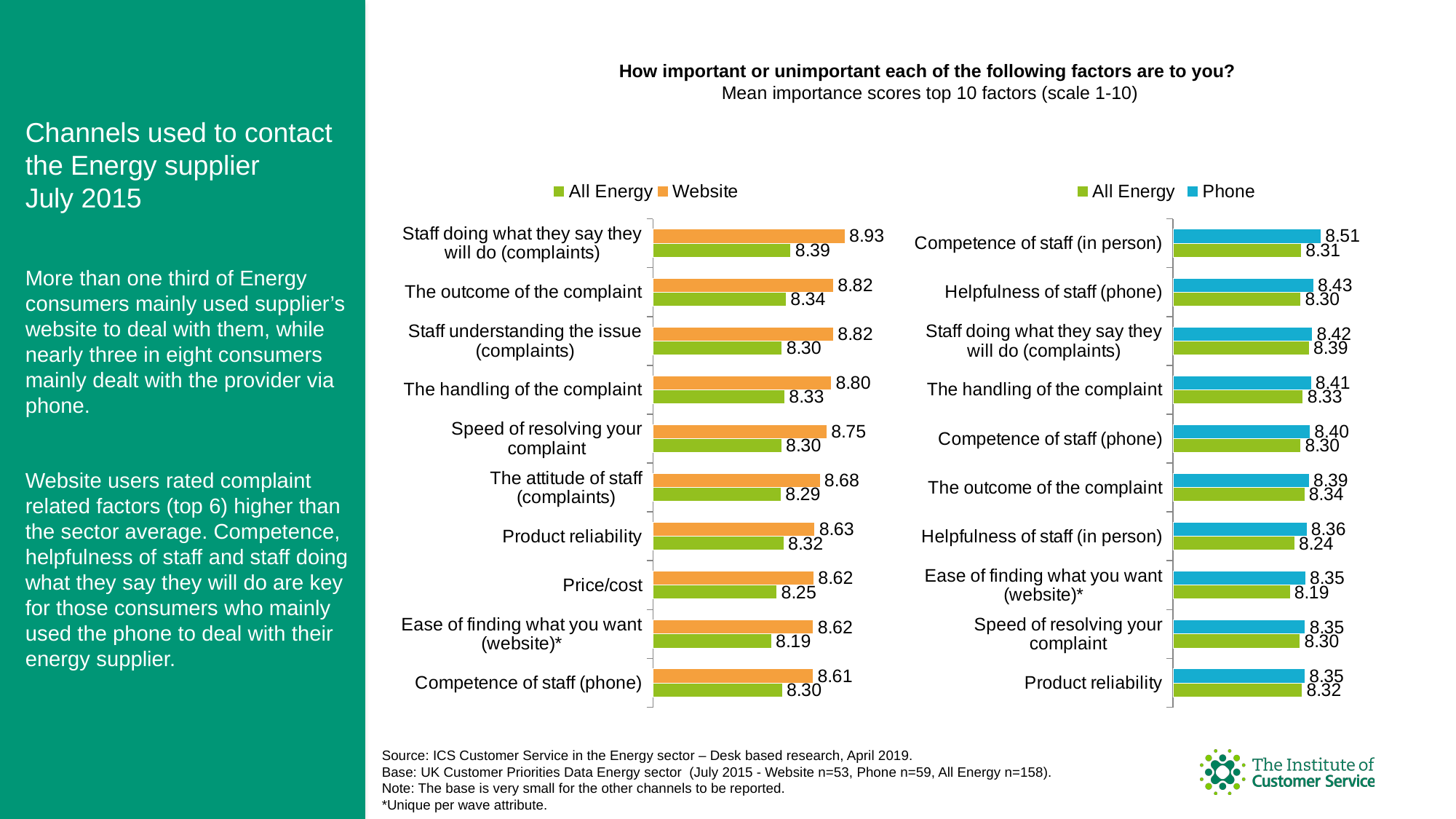
On the right chart (All Energy vs Phone), what is the difference between the Phone and All Energy values for 'Helpfulness of staff (in person)'? 0.12 On the right chart (All Energy vs Phone), which factor has the highest Phone value? Competence of staff (in person) On the left chart (All Energy vs Website), which factor has the lowest Website value? Competence of staff (phone) On the left chart (All Energy vs Website), what is the All Energy value for 'Price/cost'? 8.25 What type of chart is used on the left (All Energy vs Website)? Bar chart How many factors are listed on the left chart (All Energy vs Website)? 10 On the right chart (All Energy vs Phone), what is the Phone value for 'Competence of staff (in person)'? 8.51 On the left chart (All Energy vs Website), what is the Website value for 'Staff doing what they say they will do (complaints)'? 8.93 How many series does the legend of the right chart (All Energy vs Phone) list? 2 On the right chart (All Energy vs Phone), what colour represents the Phone series? Blue On the left chart (All Energy vs Website), what is the difference between the Website and All Energy values for 'The outcome of the complaint'? 0.48 On the right chart (All Energy vs Phone), which is larger for 'Product reliability': the Phone value or the All Energy value? Phone